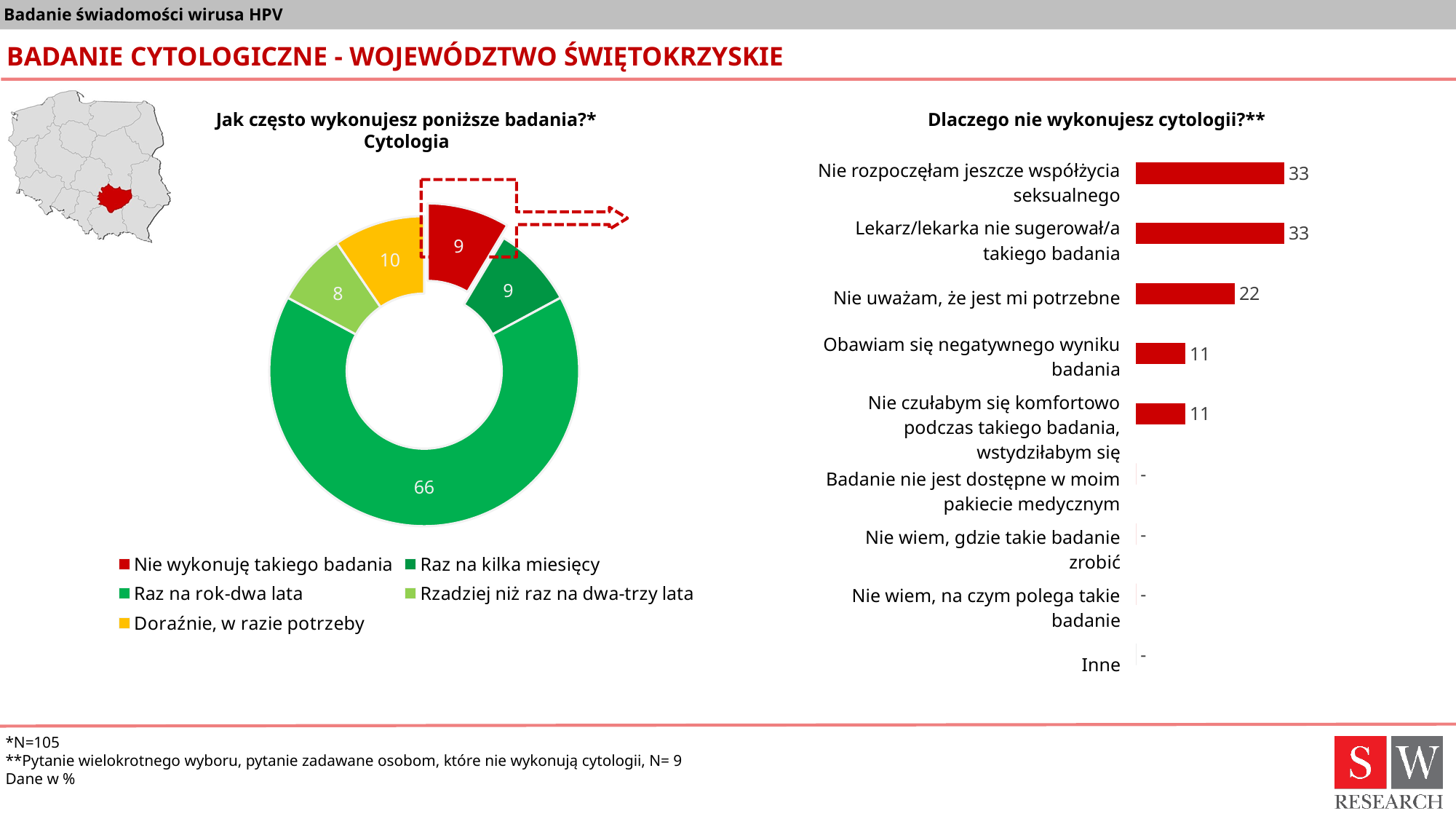
What type of chart is 'Dlaczego nie wykonujesz cytologii?'? Bar chart In the donut chart 'Jak często wykonujesz poniższe badania? Cytologia', which category has the largest share? Raz na rok-dwa lata In the donut chart 'Jak często wykonujesz poniższe badania? Cytologia', what is the difference between 'Raz na rok-dwa lata' and 'Doraźnie, w razie potrzeby'? 56 In the bar chart 'Dlaczego nie wykonujesz cytologii?', which is larger: 'Lekarz/lekarka nie sugerował/a takiego badania' or 'Nie uważam, że jest mi potrzebne'? Lekarz/lekarka nie sugerował/a takiego badania In the donut chart 'Jak często wykonujesz poniższe badania? Cytologia', how many categories does the legend list? 5 In the bar chart 'Dlaczego nie wykonujesz cytologii?', what is the value for 'Nie uważam, że jest mi potrzebne'? 22 In the donut chart 'Jak często wykonujesz poniższe badania? Cytologia', what is the value for 'Doraźnie, w razie potrzeby'? 10 In the donut chart 'Jak często wykonujesz poniższe badania? Cytologia', what is the value for 'Raz na rok-dwa lata'? 66 In the bar chart 'Dlaczego nie wykonujesz cytologii?', what is the value for 'Obawiam się negatywnego wyniku badania'? 11 In the donut chart 'Jak często wykonujesz poniższe badania? Cytologia', what is the value for 'Nie wykonuję takiego badania'? 9 In the bar chart 'Dlaczego nie wykonujesz cytologii?', how many categories are listed? 9 In the donut chart 'Jak często wykonujesz poniższe badania? Cytologia', which category has the smallest share? Rzadziej niż raz na dwa-trzy lata